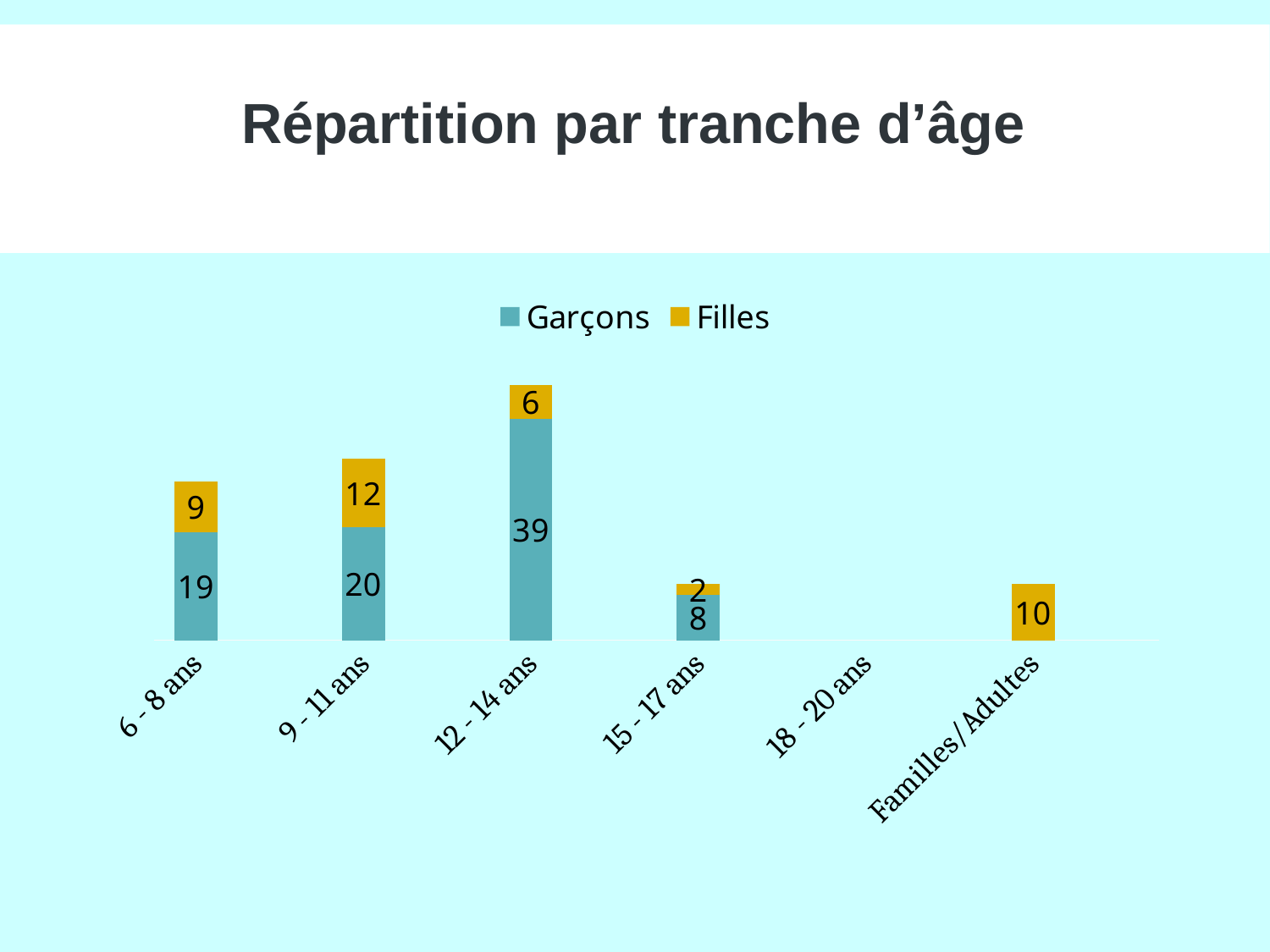
What is the Filles value for the 15 - 17 ans category? 2 What is the Garçons value for the 12 - 14 ans category? 39 How many categories are shown on the x axis? 6 Which is larger: the Filles value for 6 - 8 ans or the Filles value for 12 - 14 ans? 6 - 8 ans What is the Filles value for the 9 - 11 ans category? 12 What is the Garçons value for the 6 - 8 ans category? 19 Which category has the highest Garçons value? 12 - 14 ans How many series does the legend list? 2 What type of chart is shown on the slide? Stacked bar chart What is the difference between the Garçons values for 12 - 14 ans and 9 - 11 ans? 19 Among the categories with a Filles label, which has the lowest Filles value? 15 - 17 ans What is the total of the stacked bar for 9 - 11 ans? 32